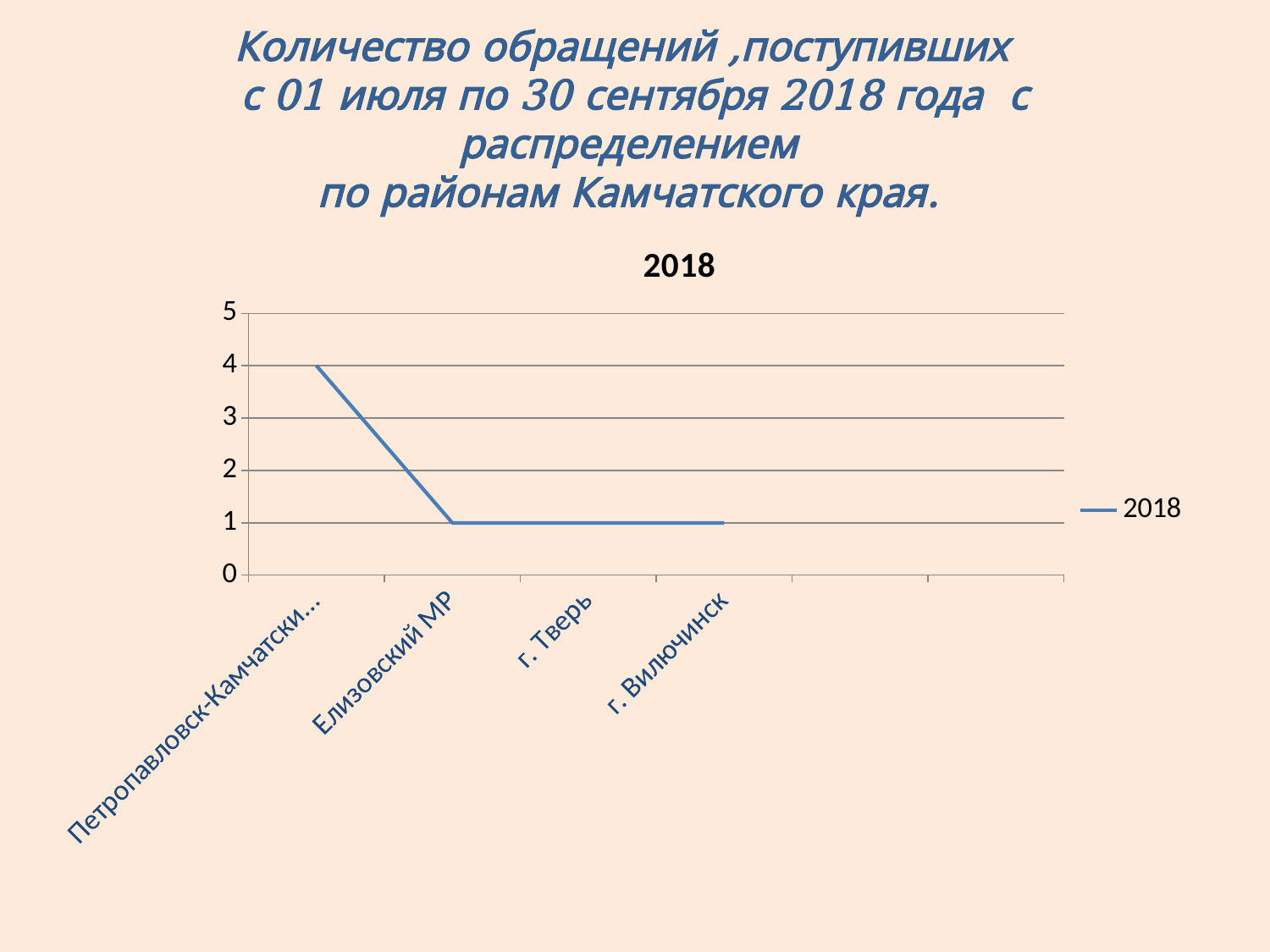
What is the title of the chart? 2018 What is the value for г. Тверь? 1 Is the value for the first category (Петропавловск-Камчатски...) greater or less than 3? greater Which category has the highest value? Петропавловск-Камчатски... What is the value for Елизовский МР? 1 What is the value for the first category on the x axis (Петропавловск-Камчатски...)? 4 How many series does the legend list? 1 What is the difference between the value for the first category (Петропавловск-Камчатски...) and the value for Елизовский МР? 3 How many labelled categories are plotted on the chart? 4 What is the value for г. Вилючинск? 1 What kind of chart is shown on the slide? line chart Which is larger, the value for the first category (Петропавловск-Камчатски...) or the value for г. Вилючинск? Петропавловск-Камчатски...